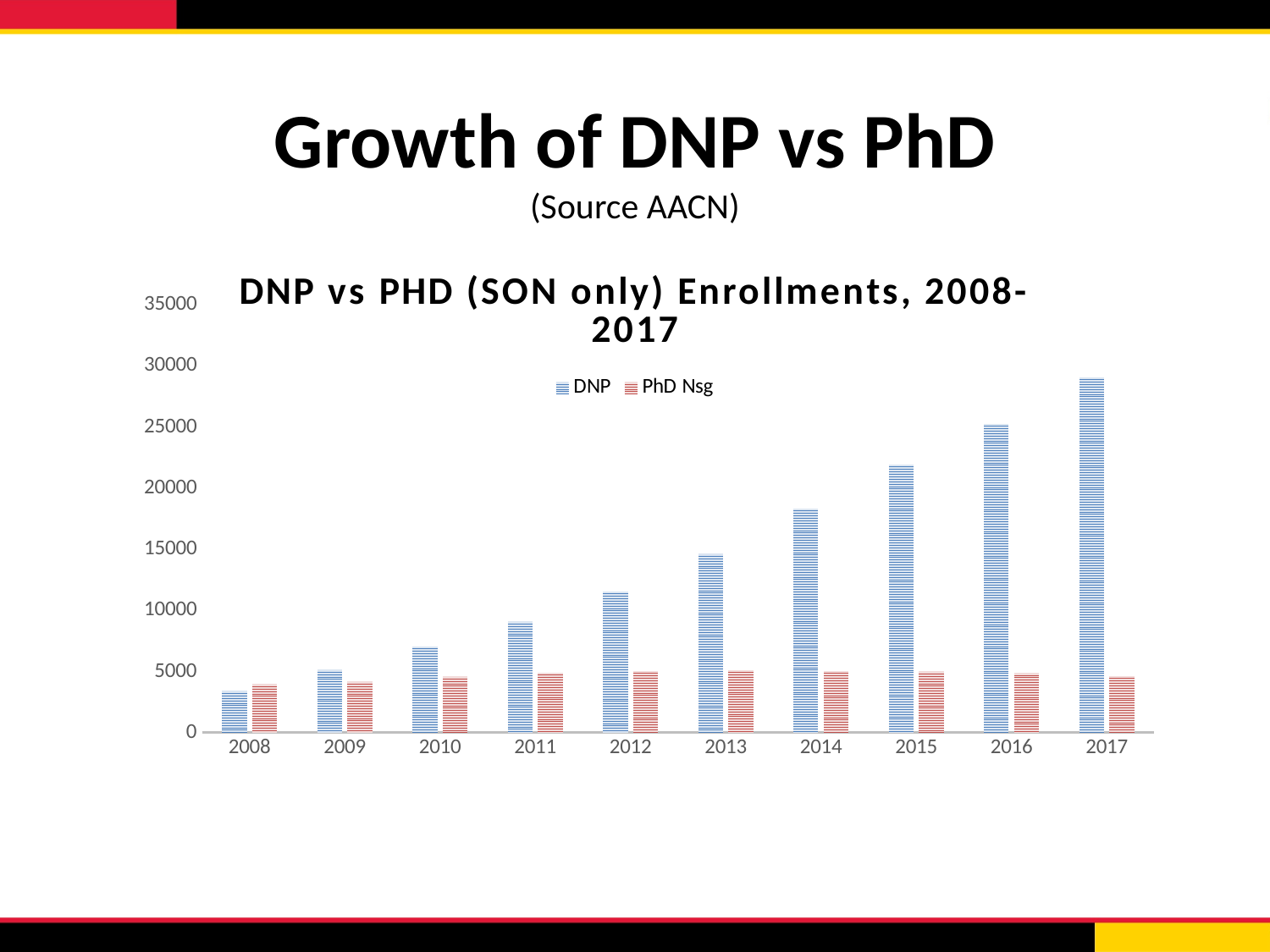
What is the title of the chart? DNP vs PHD (SON only) Enrollments, 2008-2017 What kind of chart is shown on the slide? bar chart Which year has the lowest DNP enrollment? 2008 Do DNP enrollments rise or fall from 2008 to 2017? rise How many years are shown on the x axis? 10 In 2010, which is larger, DNP or PhD Nsg enrollment? DNP Is the DNP value for 2017 greater or less than 25000? greater How many series does the legend list? 2 Is the DNP value for 2014 greater or less than 15000? greater Which year has the highest DNP enrollment? 2017 Is the DNP value for 2008 greater or less than 5000? less